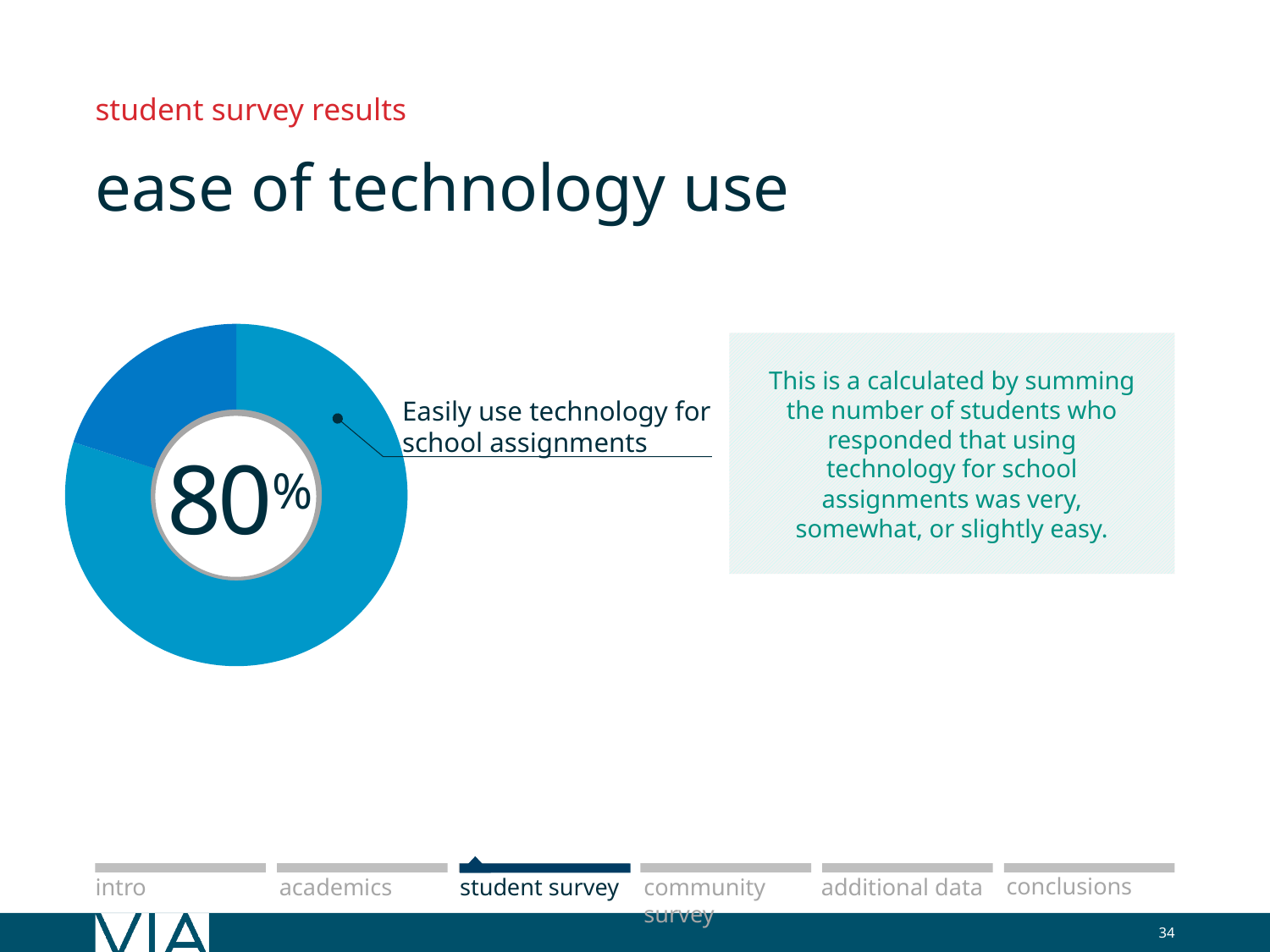
What share of the pie does the "Easily use technology for school assignments" slice represent? 80% What kind of chart is shown on the slide? pie chart (donut) Which slice of the pie chart is the largest? Easily use technology for school assignments How many slices does the pie chart have? 2 Is the labelled slice ("Easily use technology for school assignments") larger or smaller than the unlabelled slice? larger What value is printed in the centre of the donut chart? 80% What percentage is shown for the slice labelled "Easily use technology for school assignments"? 80% What is the title of the slide containing the pie chart? ease of technology use